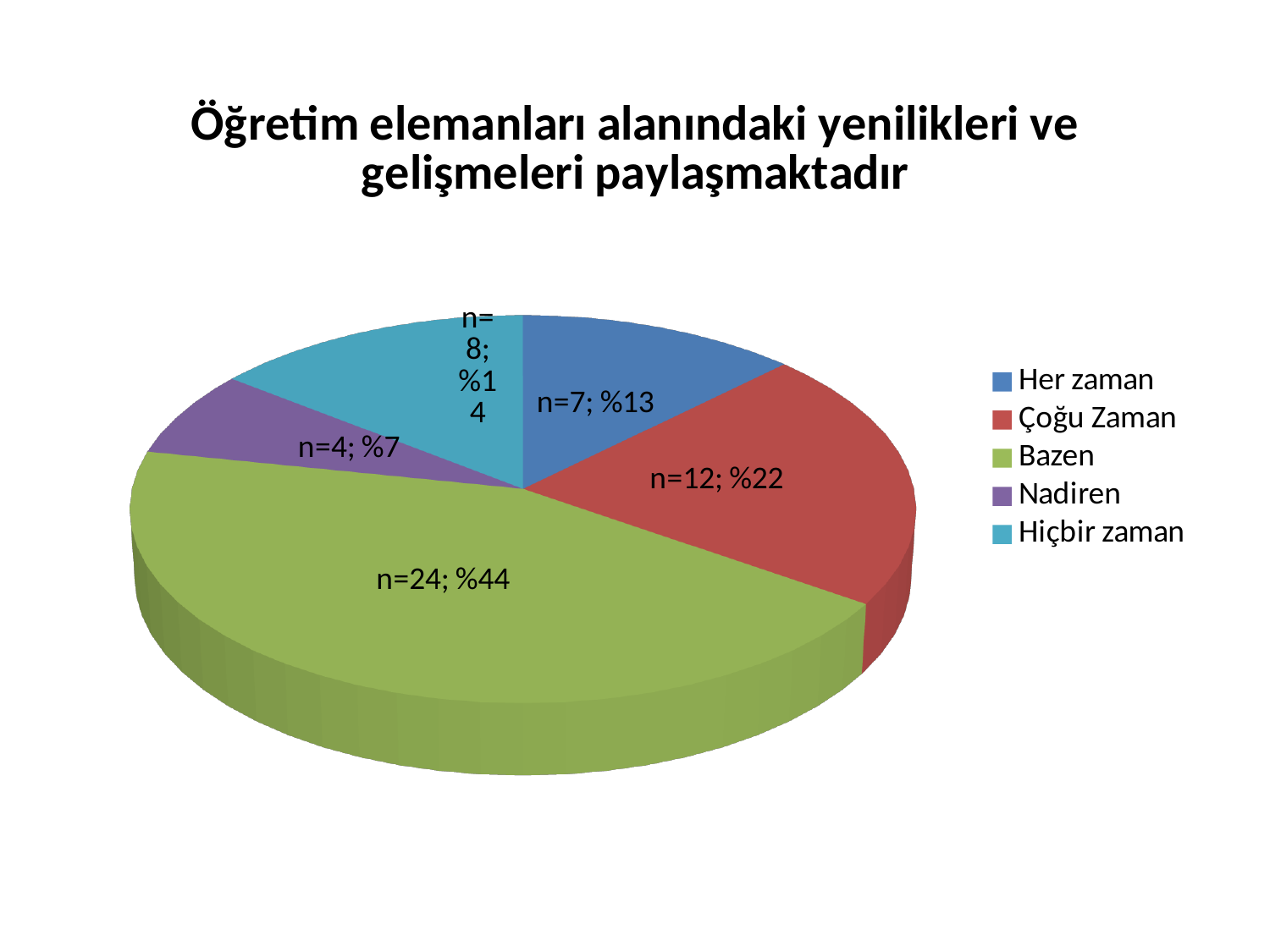
Which category has the smallest slice of the pie? Nadiren What kind of chart is shown on the slide? pie chart How many categories does the legend of the pie chart list? 5 What is the difference in n between 'Bazen' and 'Çoğu Zaman'? 12 What is the n value for the 'Çoğu Zaman' slice? n=12 Which is larger, the n for 'Hiçbir zaman' or the n for 'Her zaman'? Hiçbir zaman What percentage share does the 'Bazen' slice have? %44 What is the n value for the 'Nadiren' slice? n=4 What is the n value for the 'Bazen' slice? n=24 What percentage share does the 'Hiçbir zaman' slice have? %14 Which category has the largest slice of the pie? Bazen What percentage share does the 'Her zaman' slice have? %13